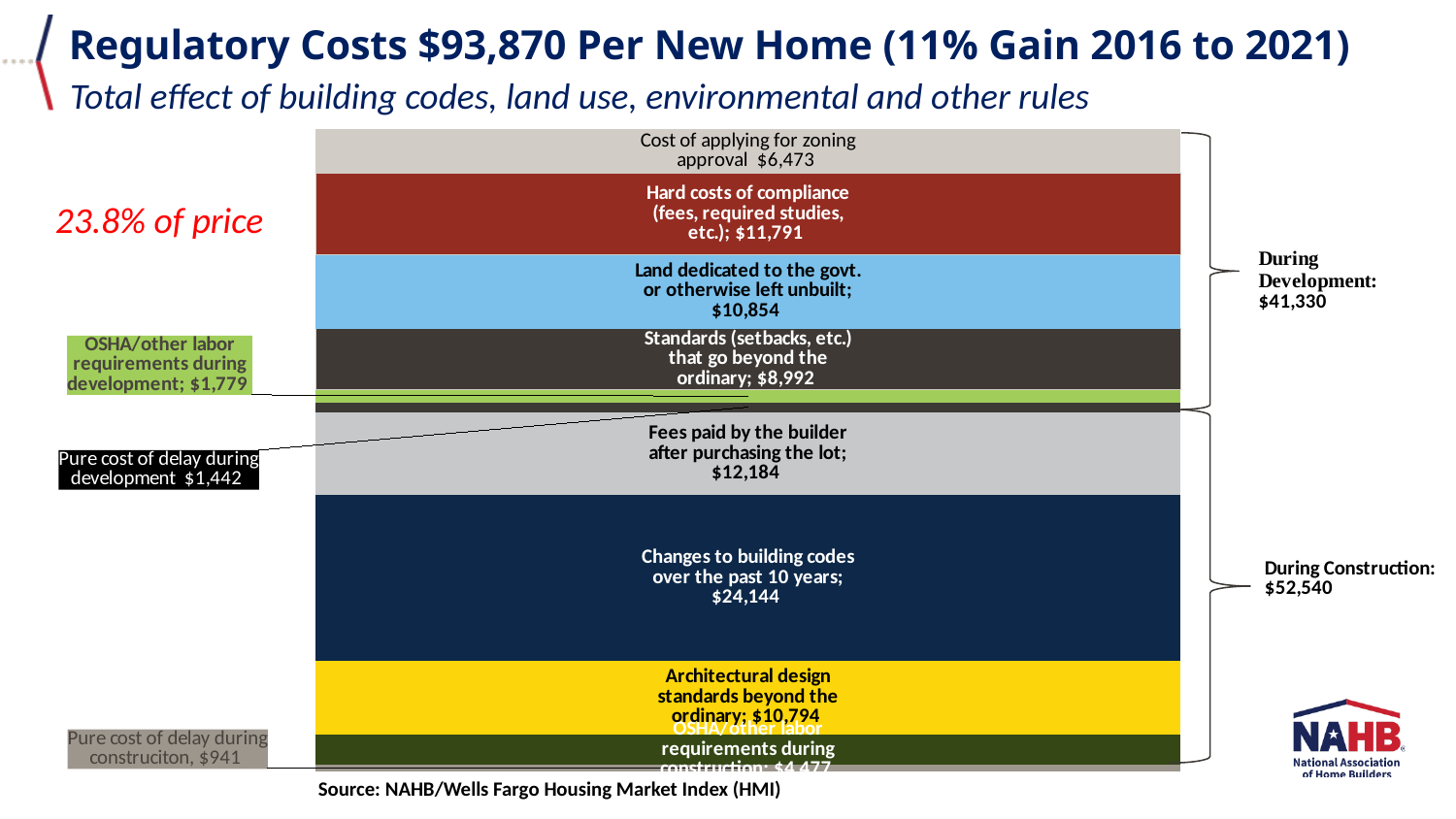
What is the value for 'Changes to building codes over the past 10 years'? $24,144 Which is larger: 'Architectural design standards beyond the ordinary' or 'Land dedicated to the govt. or otherwise left unbuilt'? Land dedicated to the govt. or otherwise left unbuilt What is the total of the 'During Development' segments? $41,330 What is the value for 'Hard costs of compliance (fees, required studies, etc.)'? $11,791 Which segment of the stacked bar has the largest value? Changes to building codes over the past 10 years What is the difference between the 'During Construction' total and the 'During Development' total? $11,210 What is the value for 'OSHA/other labor requirements during development'? $1,779 What is the difference between 'Fees paid by the builder after purchasing the lot' and 'Land dedicated to the govt. or otherwise left unbuilt'? $1,330 Which segment of the stacked bar has the smallest value? Pure cost of delay during construction What is the total of the 'During Construction' segments? $52,540 What is the value for 'Cost of applying for zoning approval'? $6,473 What kind of chart is shown on the slide? Stacked bar chart